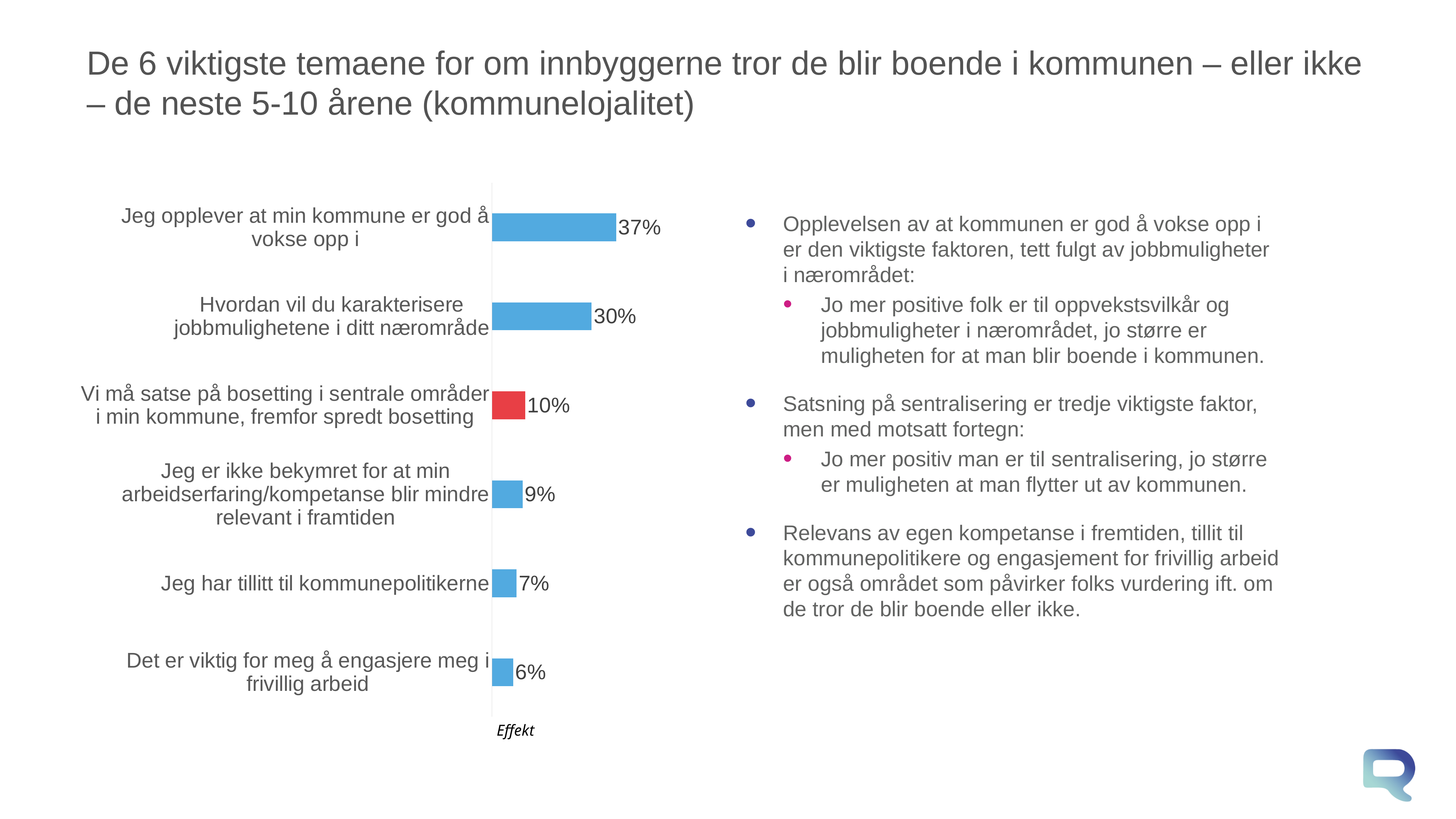
What is the value for "Vi må satse på bosetting i sentrale områder i min kommune, fremfor spredt bosetting"? 10% What is the value for "Jeg opplever at min kommune er god å vokse opp i"? 37% Which is larger: the value for "Jeg er ikke bekymret for at min arbeidserfaring/kompetanse blir mindre relevant i framtiden" or the value for "Det er viktig for meg å engasjere meg i frivillig arbeid"? Jeg er ikke bekymret for at min arbeidserfaring/kompetanse blir mindre relevant i framtiden What is the value for "Jeg har tillitt til kommunepolitikerne"? 7% Which category's bar is coloured red instead of blue? Vi må satse på bosetting i sentrale områder i min kommune, fremfor spredt bosetting What kind of chart is shown on the slide? Bar chart What is the value for "Hvordan vil du karakterisere jobbmulighetene i ditt nærområde"? 30% Which category has the highest value? Jeg opplever at min kommune er god å vokse opp i What is the difference between the values for "Jeg opplever at min kommune er god å vokse opp i" and "Hvordan vil du karakterisere jobbmulighetene i ditt nærområde"? 7% What is the label shown beneath the chart's axis? Effekt How many categories are shown in the chart? 6 Which category has the lowest value? Det er viktig for meg å engasjere meg i frivillig arbeid